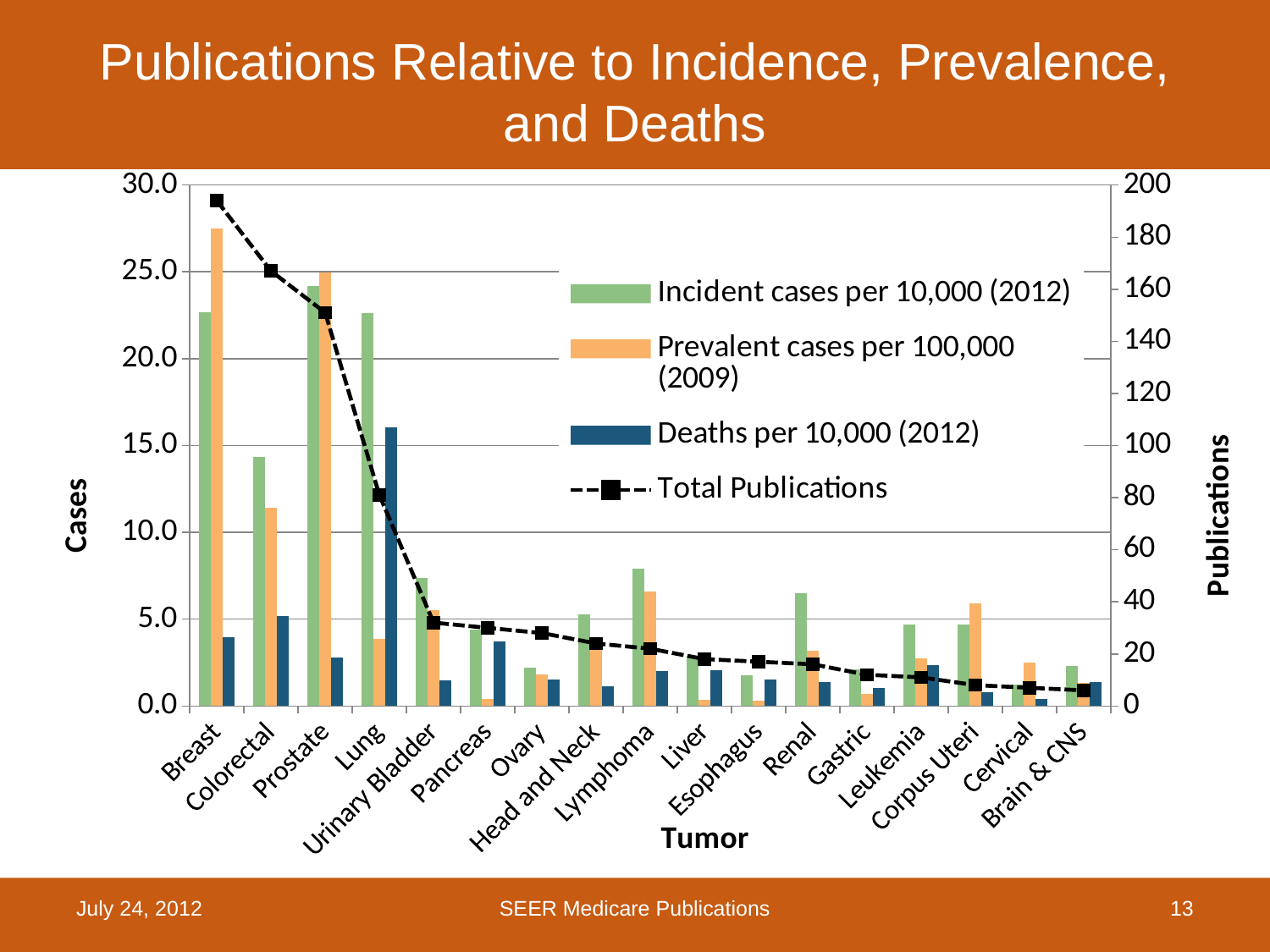
What is the label of the right-hand vertical axis? Publications Which tumor has the highest value for Prevalent cases per 100,000 (2009)? Breast Is the Total Publications value for Breast greater or less than 180? greater Is the Deaths per 10,000 (2012) value for Lung greater or less than 10? greater Which has more Deaths per 10,000 (2012), Lung or Breast? Lung Which tumor has the highest value for Deaths per 10,000 (2012)? Lung Do the Total Publications values generally rise or fall moving from left to right along the x axis? fall How many tumor categories are shown on the x axis? 17 Which tumor has the highest number of Total Publications? Breast How many series does the legend list? 4 Is the Incident cases per 10,000 (2012) value for Colorectal greater or less than 15? less What kind of chart is shown on the slide? A combined bar and line chart